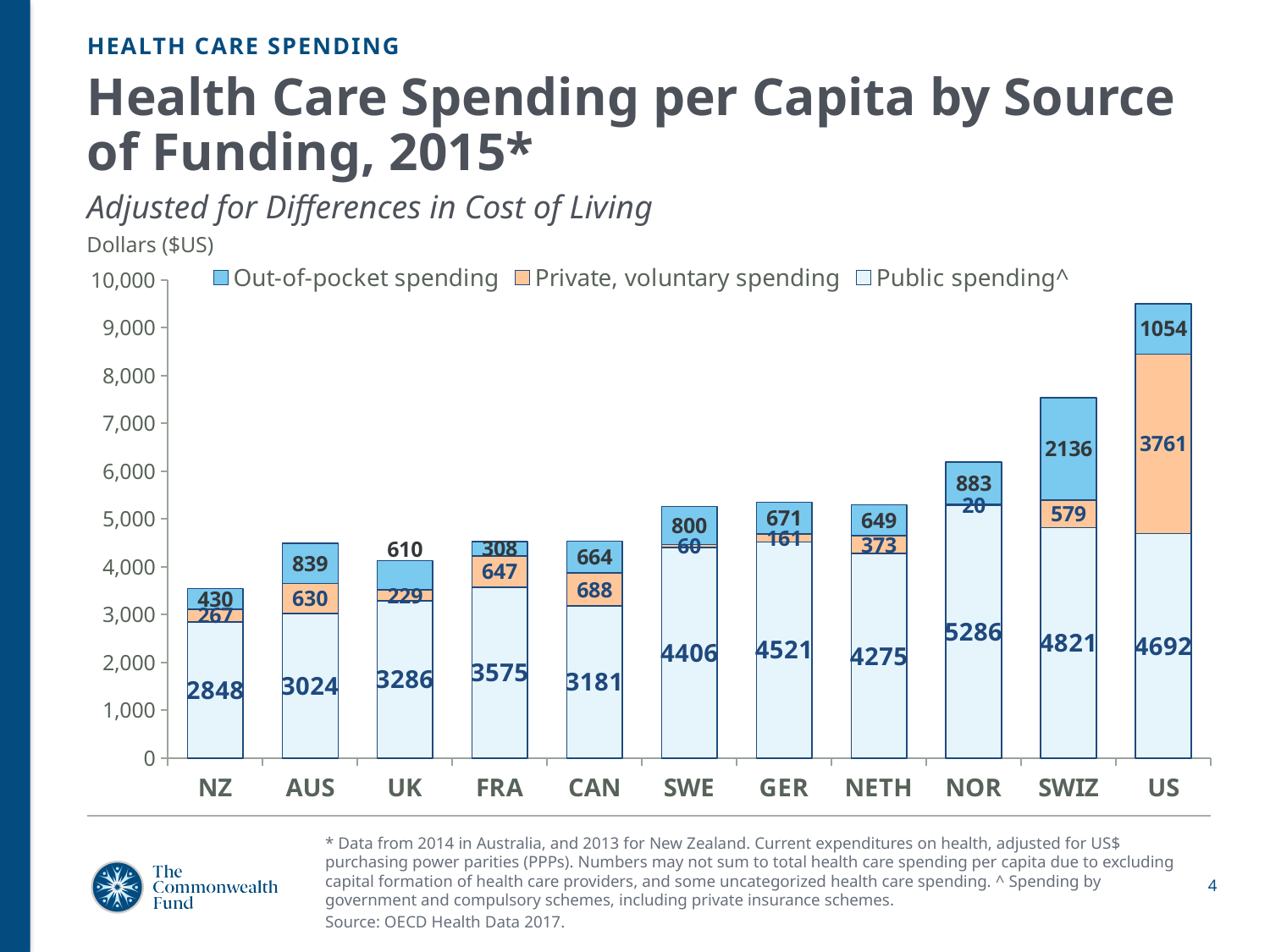
What is the difference between public spending in GER and SWE? 115 What is the private, voluntary spending value for the US? 3761 Which country has the lowest public spending? NZ What is the total health care spending per capita for the US, summing the three segments? 9507 Which country has the lowest private, voluntary spending? NOR Which has higher out-of-pocket spending, AUS or UK? AUS What is the public spending value for NOR? 5286 How many countries are shown on the x axis? 11 What kind of chart is shown on the slide? Stacked bar chart Is the total bar height for NOR greater or less than 6,000? greater Which country has the highest out-of-pocket spending? SWIZ How many series does the legend list? 3